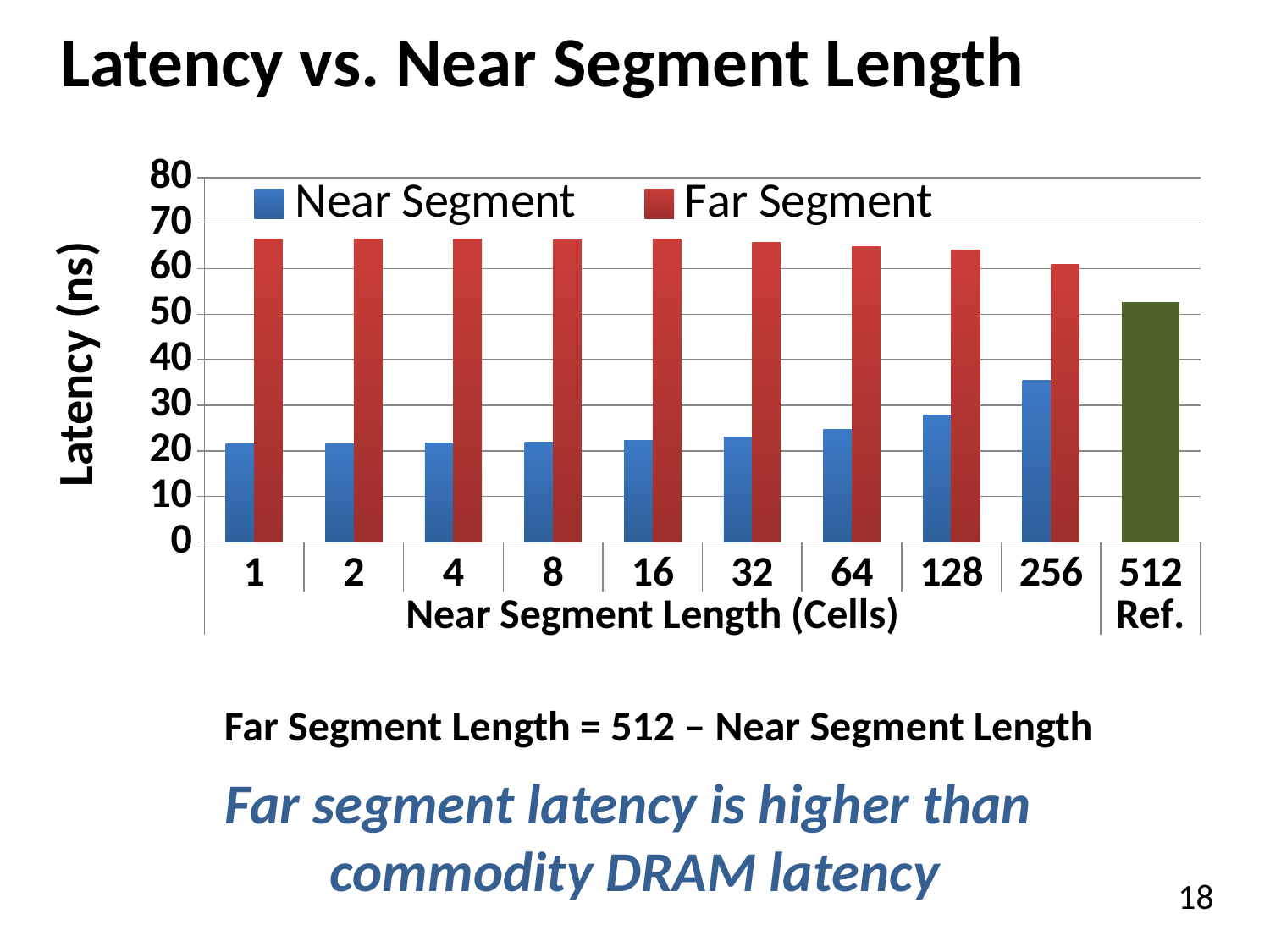
What is the title of the chart? Latency vs. Near Segment Length Is the Near Segment latency at near segment length 1 greater or less than 30? less How many series does the legend list? 2 Is the Far Segment latency at near segment length 1 greater or less than 60? greater Is the latency of the 512 Ref. bar greater or less than 60? less What is the label of the y axis? Latency (ns) How many categories are shown along the x axis? 10 What kind of chart is shown on the slide? bar chart At which near segment length is the Far Segment latency lowest? 256 At which near segment length is the Near Segment latency highest? 256 Which is larger at near segment length 256: the Far Segment latency or the 512 Ref. latency? Far Segment